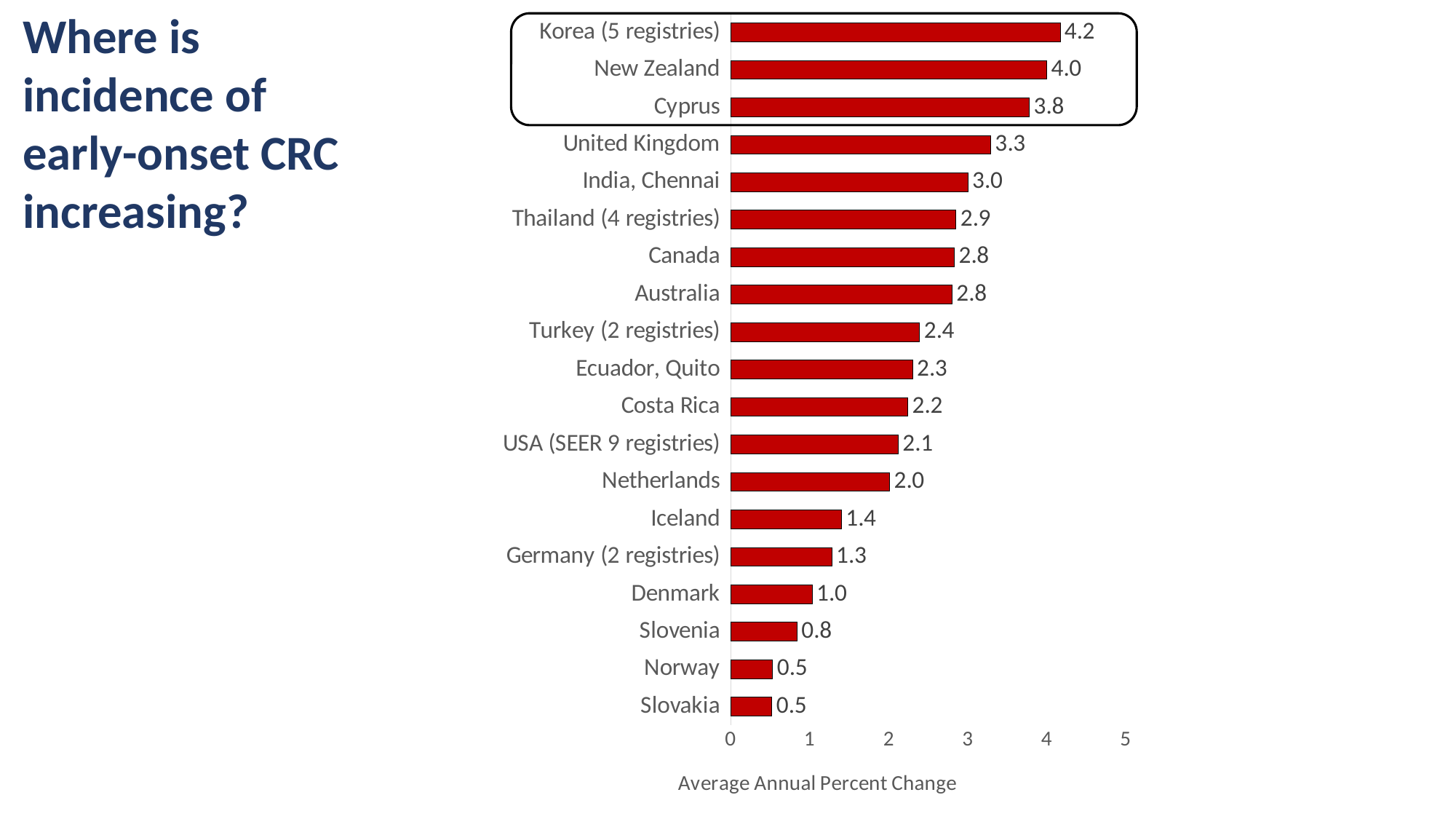
What is the value shown for the United Kingdom? 3.3 What is the value shown for USA (SEER 9 registries)? 2.1 Which country has the highest average annual percent change? Korea (5 registries) What is the value shown for Denmark? 1.0 What kind of chart is shown on the slide? Bar chart What is the average annual percent change for Korea (5 registries)? 4.2 How many countries or regions are shown in the chart? 19 What is the label of the horizontal axis? Average Annual Percent Change What is the difference between the values for Korea (5 registries) and Slovakia? 3.7 Which has a larger value, Turkey (2 registries) or Netherlands? Turkey (2 registries) Which has a larger value, Iceland or Germany (2 registries)? Iceland What is the difference between the values for New Zealand and Cyprus? 0.2